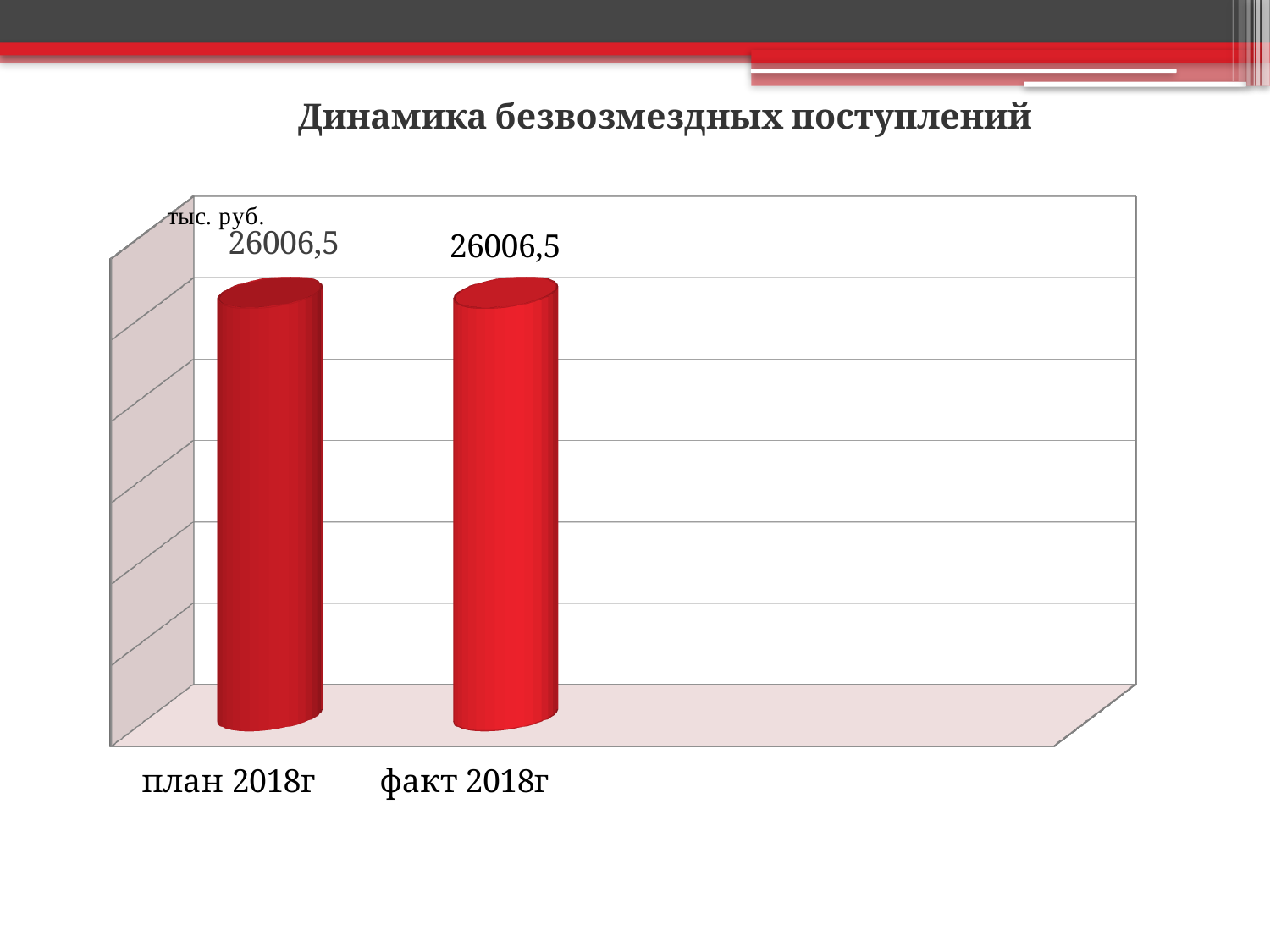
What is the value for факт 2018г? 26006,5 How many categories are plotted on the chart? 2 What kind of chart is shown on the slide? bar chart In what units are the values on the chart given? тыс. руб. Do the values rise, fall, or stay the same from план 2018г to факт 2018г? stay the same What is the value for план 2018г? 26006,5 Is the value for факт 2018г larger than, smaller than, or equal to the value for план 2018г? equal What is the difference between the values for план 2018г and факт 2018г? 0 What is the title of the chart? Динамика безвозмездных поступлений